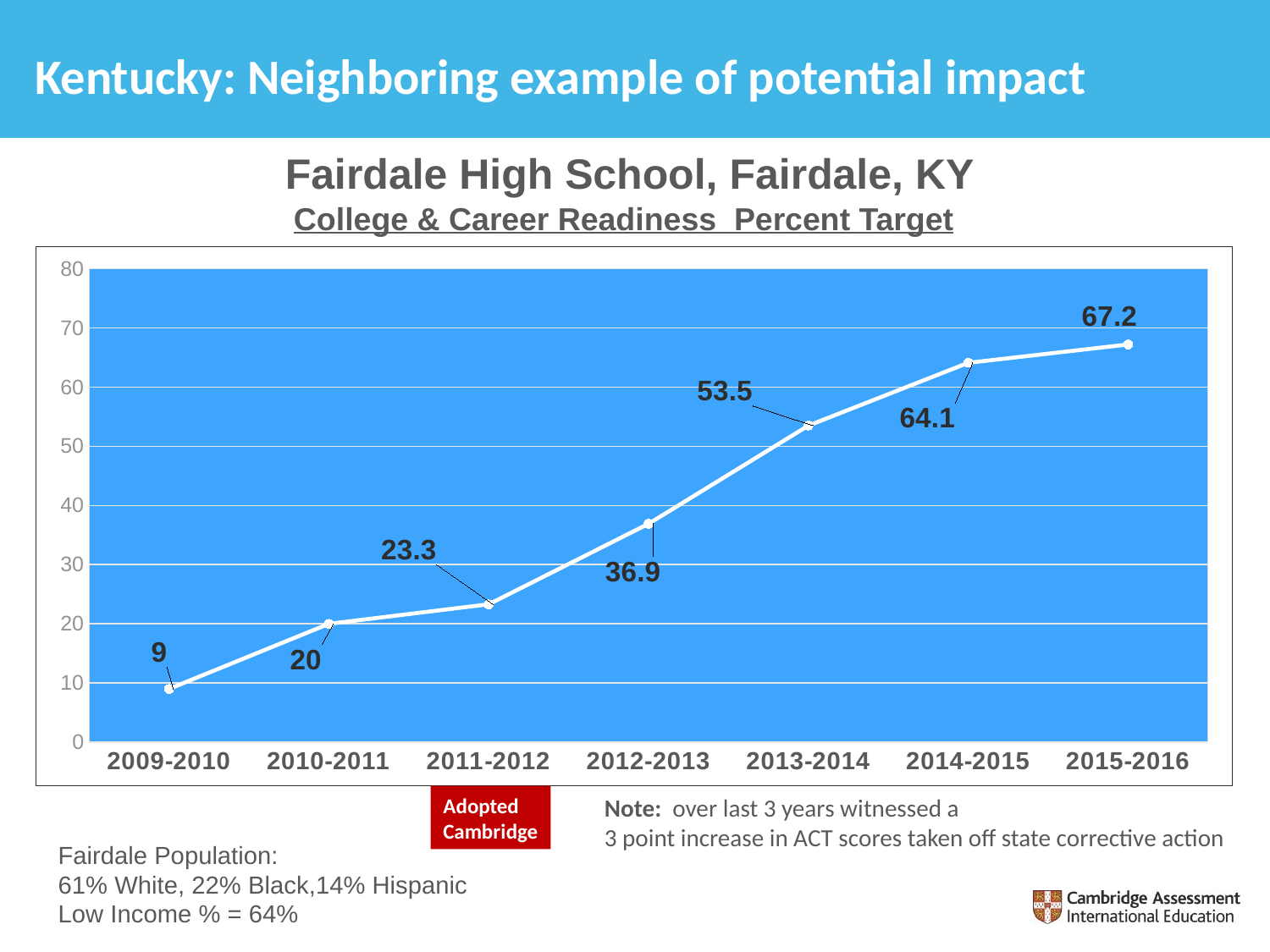
Which school year has the lowest value on the chart? 2009-2010 What is the value plotted for 2015-2016? 67.2 Which is larger, the value for 2010-2011 or the value for 2011-2012? 2011-2012 Do the values rise or fall from 2009-2010 to 2015-2016? rise What is the difference between the values for 2013-2014 and 2012-2013? 16.6 What is the College & Career Readiness percent target for 2009-2010? 9 Which school year has the highest value on the chart? 2015-2016 What kind of chart is shown on the slide? line chart How many school years are plotted on the chart? 7 What is the value plotted for 2014-2015? 64.1 Is the value for 2013-2014 greater or less than 50? greater What is the value plotted for 2012-2013? 36.9